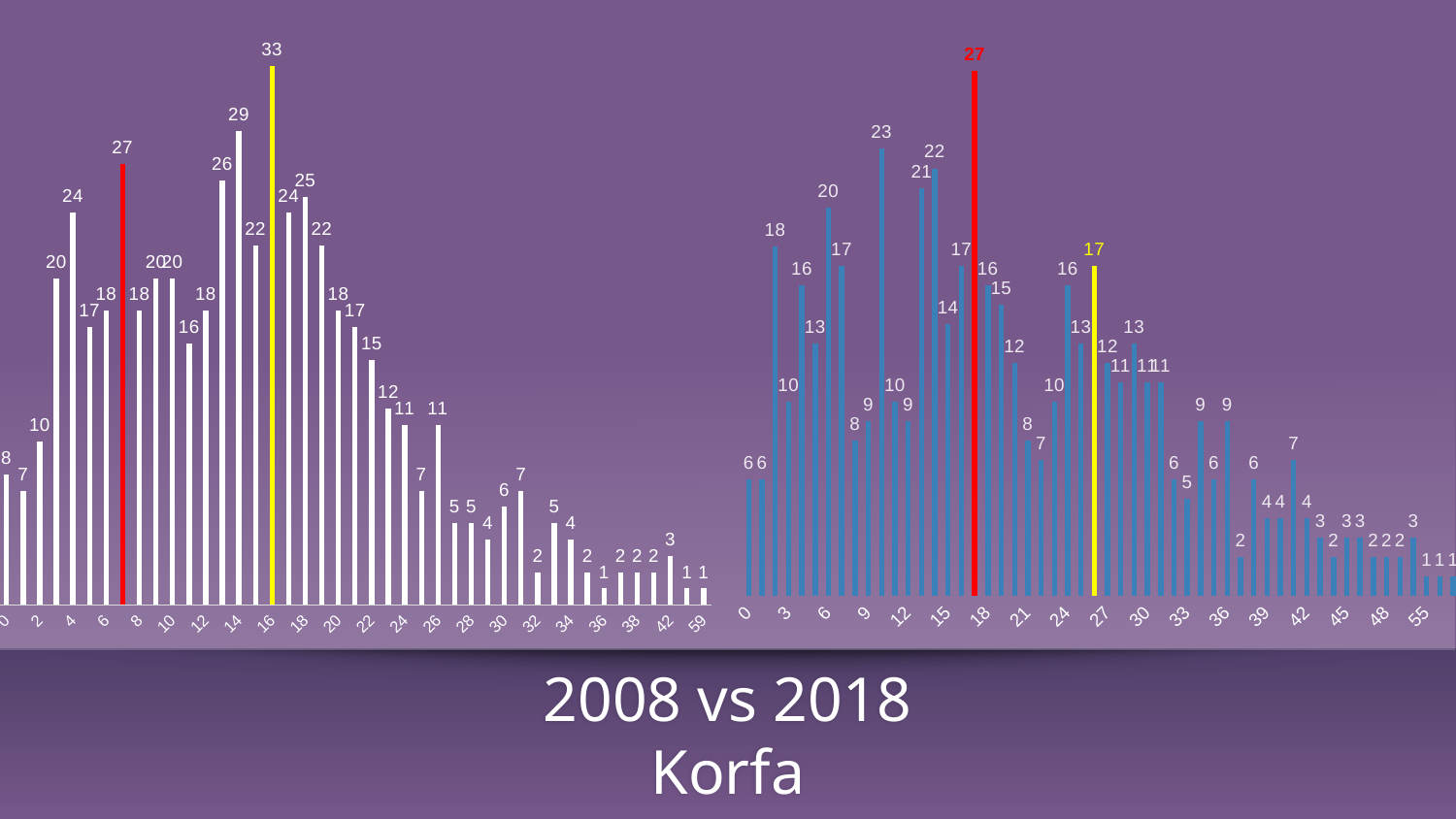
In the right (blue bars) chart, what is the highest labelled value? 27 In the left (white bars) chart, what value is labelled on the red bar? 27 In the right (blue bars) chart, do the values generally rise or fall moving right from the red bar toward the end of the x axis? fall In the left (white bars) chart, what value is labelled on the yellow bar? 33 In the right (blue bars) chart, what value is labelled on the yellow bar? 17 Which chart has the taller peak bar, the left (white bars) chart or the right (blue bars) chart? the left chart What kind of chart is shown on the left side of the slide? bar chart In the right (blue bars) chart, what value is labelled on the red bar? 27 In the left (white bars) chart, what is the difference between the yellow bar's value and the red bar's value? 6 In the left (white bars) chart, what is the highest labelled value? 33 In the right (blue bars) chart, what is the difference between the red bar's value and the yellow bar's value? 10 What is the title text shown below the charts? 2008 vs 2018 Korfa